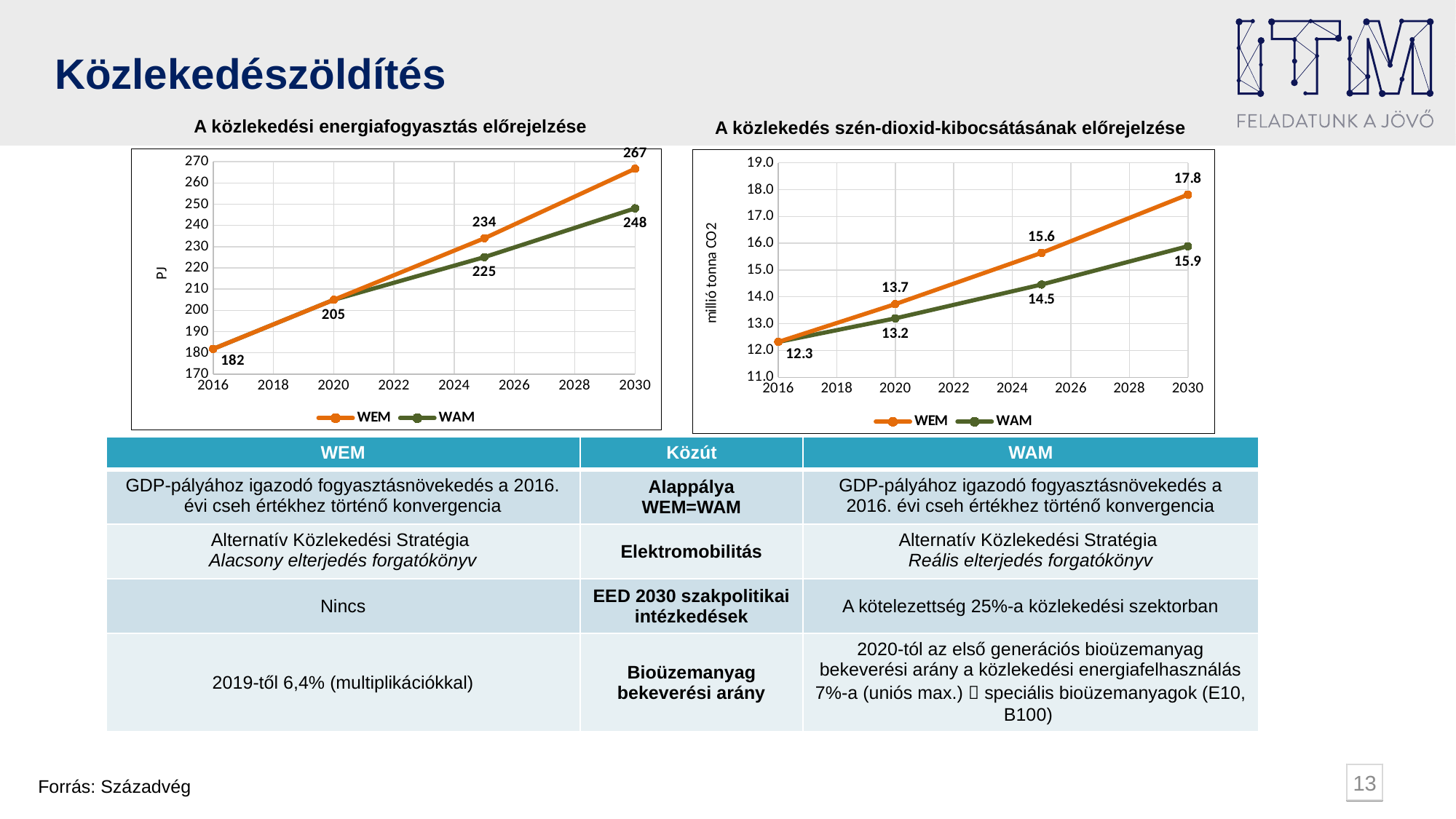
In the chart 'A közlekedés szén-dioxid-kibocsátásának előrejelzése', what is the WEM value in 2025? 15.6 In the chart 'A közlekedés szén-dioxid-kibocsátásának előrejelzése', what is the WAM value in 2030? 15.9 In the chart 'A közlekedési energiafogyasztás előrejelzése', what is the WEM value in 2030? 267 In the chart 'A közlekedési energiafogyasztás előrejelzése', what is the WAM value in 2025? 225 In the chart 'A közlekedés szén-dioxid-kibocsátásának előrejelzése', what is the value in 2016? 12.3 In the chart 'A közlekedési energiafogyasztás előrejelzése', do the values rise or fall from 2016 to 2030? rise In the chart 'A közlekedési energiafogyasztás előrejelzése', what is the difference between the WEM and WAM values in 2030? 19 How many series does the legend list in the chart 'A közlekedés szén-dioxid-kibocsátásának előrejelzése'? 2 In the chart 'A közlekedés szén-dioxid-kibocsátásának előrejelzése', which series has the higher value in 2030, WEM or WAM? WEM In the chart 'A közlekedési energiafogyasztás előrejelzése', what is the unit shown on the vertical axis? PJ In the chart 'A közlekedés szén-dioxid-kibocsátásának előrejelzése', what is the difference between the WEM and WAM values in 2020? 0.5 What type of chart is 'A közlekedési energiafogyasztás előrejelzése'? line chart